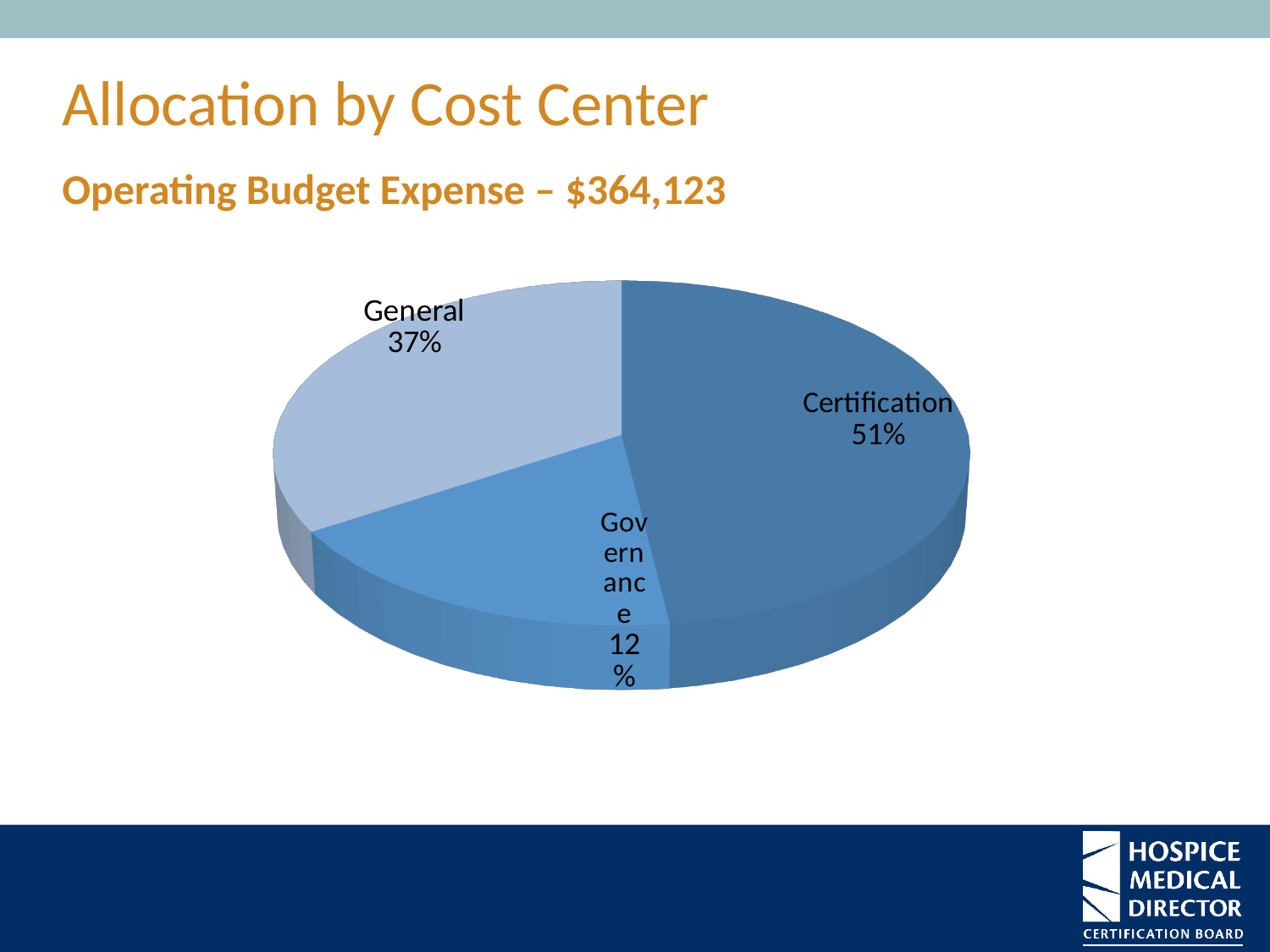
What is the difference in percentage points between the General and Governance shares? 25 Which cost center has the largest share of the pie? Certification What share of the pie does General represent? 37% Which cost center has the smallest share of the pie? Governance What is the title of the slide containing the chart? Allocation by Cost Center What is the difference in percentage points between the Certification and General shares? 14 What operating budget expense total is stated above the chart? $364,123 What share of the pie does Certification represent? 51% What kind of chart is shown on the slide? Pie chart How many slices does the pie chart have? 3 What share of the pie does Governance represent? 12% Which is larger, the share for General or the share for Governance? General